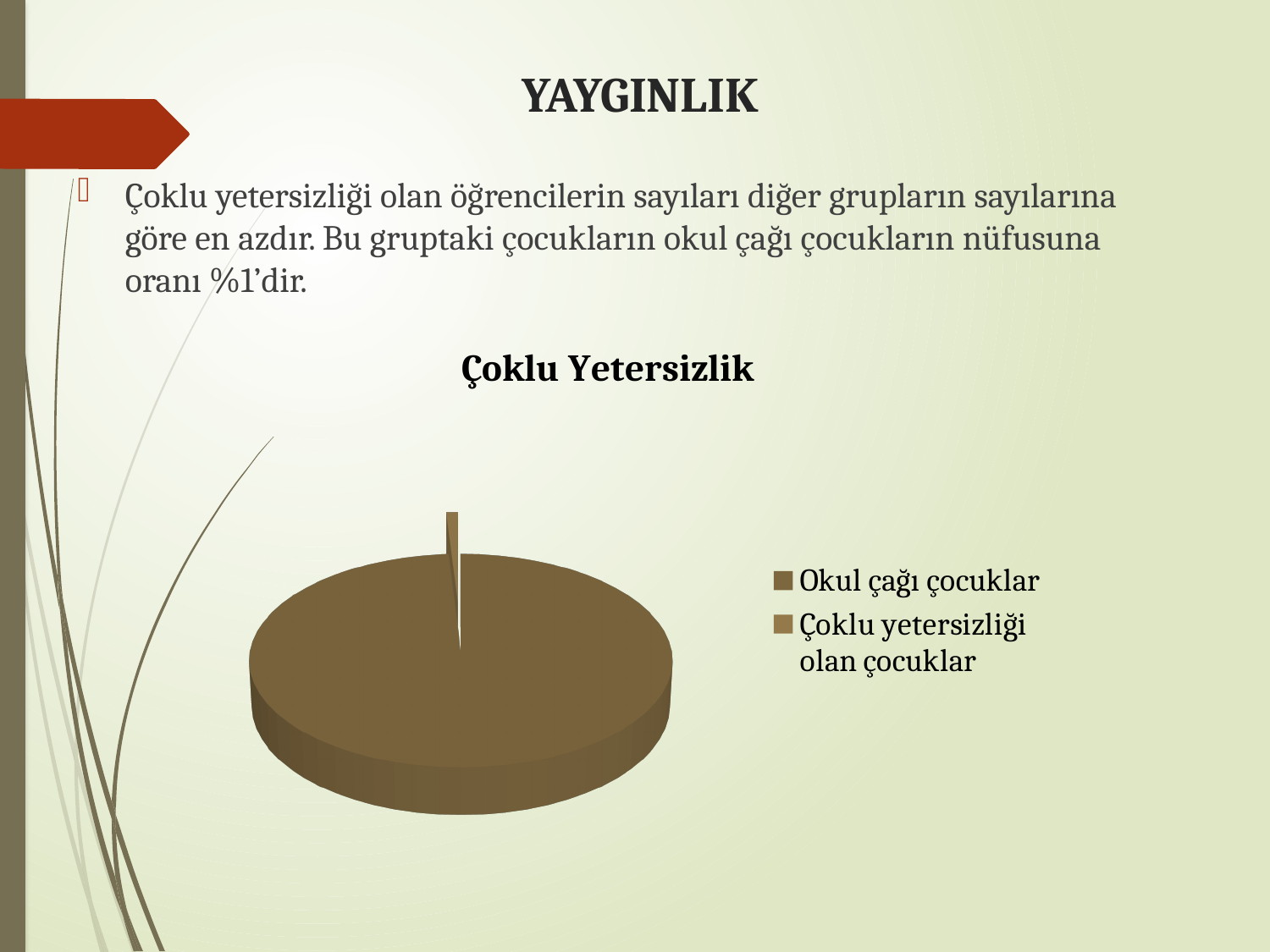
How many entries does the chart legend list? 2 What is the first entry listed in the chart legend? Okul çağı çocuklar Which category has the smallest slice of the pie? Çoklu yetersizliği olan çocuklar What kind of chart is shown on the slide? pie chart How many categories does the pie chart have? 2 Which slice is larger: Okul çağı çocuklar or Çoklu yetersizliği olan çocuklar? Okul çağı çocuklar Which category has the largest slice of the pie? Okul çağı çocuklar What is the title of the chart? Çoklu Yetersizlik